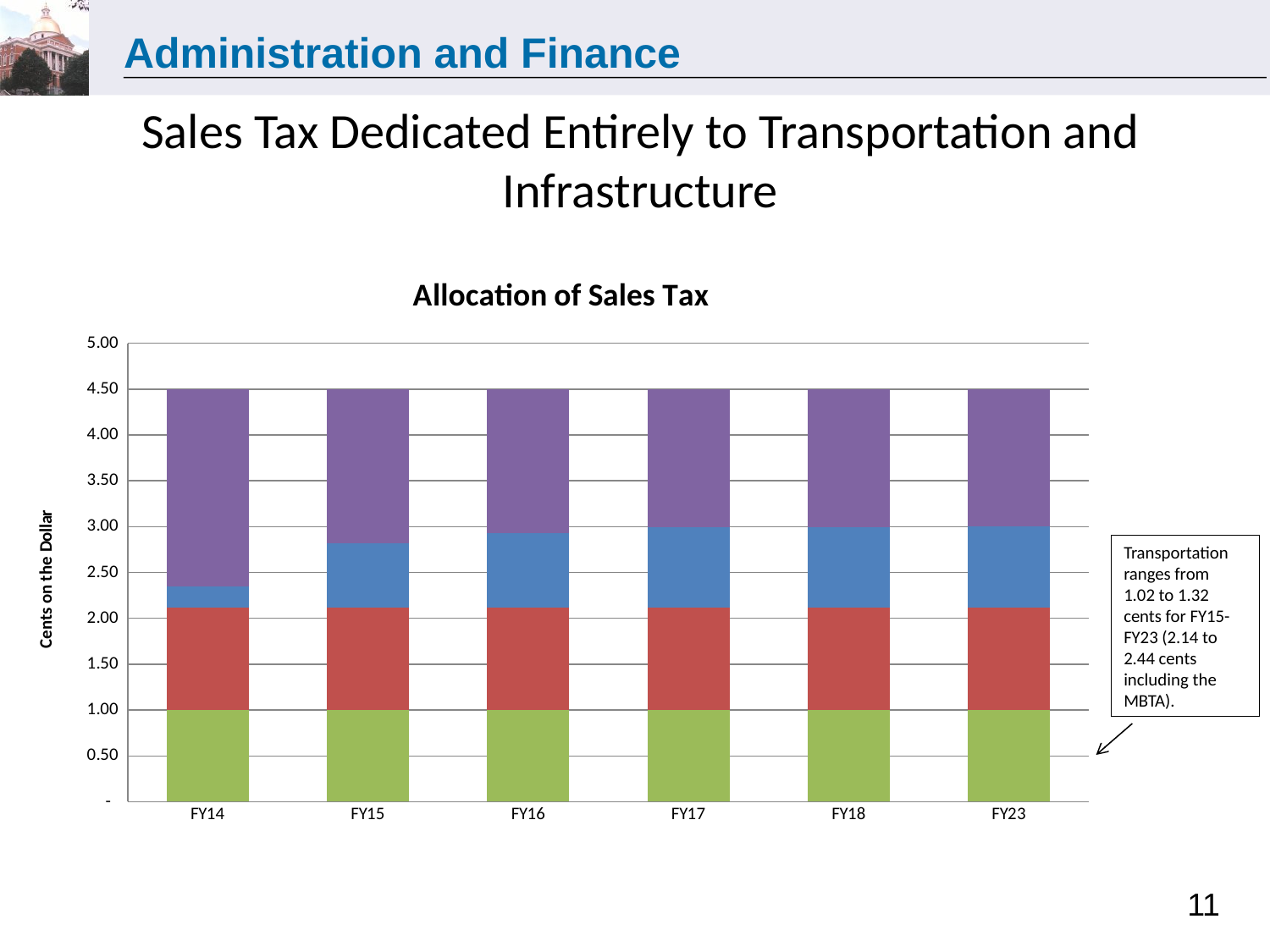
What is the title of the chart? Allocation of Sales Tax Is the total for FY18 greater or less than 4.00? greater Which bar has the larger blue segment, FY14 or FY15? FY15 What is the label on the vertical axis of the chart? Cents on the Dollar How many fiscal years are shown along the x axis of the chart? 6 What is the total height of the stacked bar for FY23? 4.50 What kind of chart is shown on the slide? Stacked bar chart Does the blue segment grow or shrink from FY14 to FY23? Grows What value does the bottom (green) segment reach in each bar? 1.00 Is the top of the blue segment for FY14 greater or less than 2.50? less What is the total height of the stacked bar for FY14? 4.50 Is the top of the blue segment for FY15 greater or less than 3.00? less